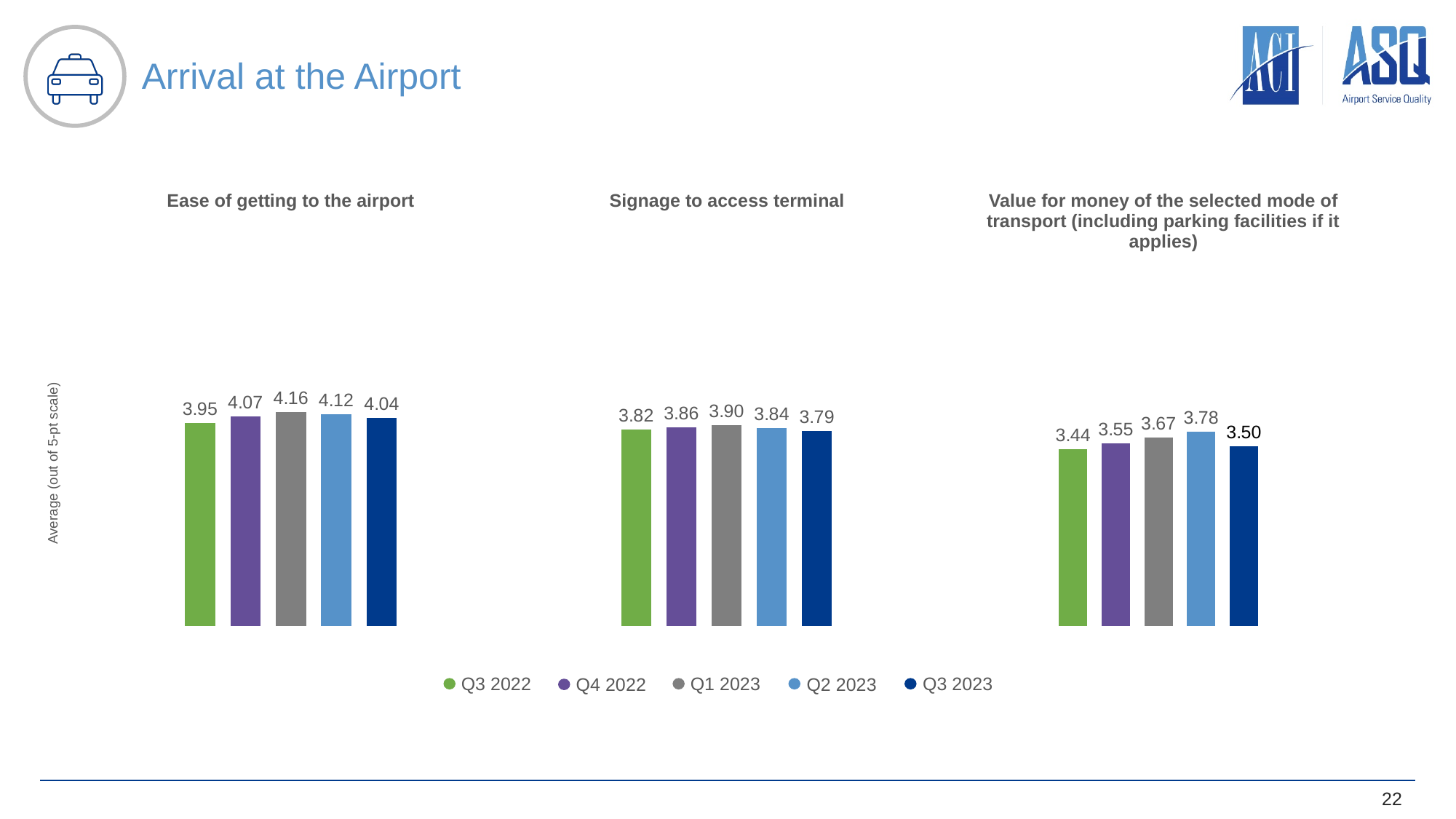
In the 'Signage to access terminal' chart, which quarter has the highest value? Q1 2023 What is the label on the vertical axis of the charts? Average (out of 5-pt scale) In the 'Ease of getting to the airport' chart, what is the value for Q1 2023? 4.16 What kind of chart is used for 'Signage to access terminal'? bar chart In the 'Value for money of the selected mode of transport' chart, what is the difference between the Q2 2023 and Q3 2023 values? 0.28 In the 'Signage to access terminal' chart, which is larger, the value for Q4 2022 or the value for Q3 2023? Q4 2022 In the 'Ease of getting to the airport' chart, what is the difference between the Q1 2023 and Q3 2022 values? 0.21 In the 'Value for money of the selected mode of transport' chart, what is the value for Q3 2022? 3.44 In the 'Signage to access terminal' chart, what is the value for Q3 2023? 3.79 In the 'Value for money of the selected mode of transport' chart, which quarter has the lowest value? Q3 2022 In the 'Ease of getting to the airport' chart, which quarter has the highest value? Q1 2023 How many series does the legend list? 5